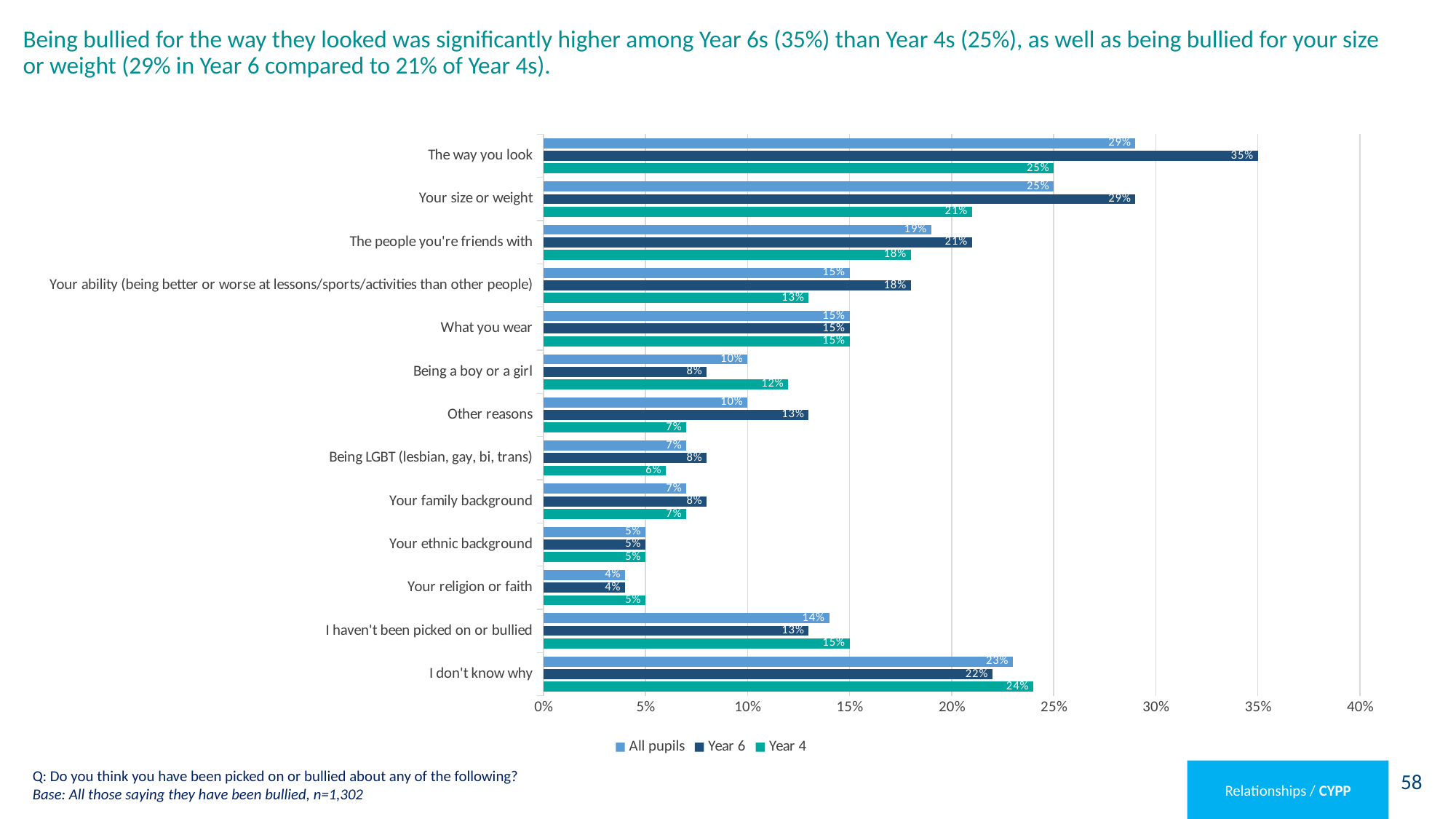
What is the Year 6 value for "Other reasons"? 13% What is the Year 4 value for "Your size or weight"? 21% Which series is shown in green in the legend? Year 4 What kind of chart is shown on the slide? Bar chart Which category has the highest Year 6 value? The way you look How many categories are shown on the chart? 13 Which is larger for "Being a boy or a girl": the Year 6 value or the Year 4 value? Year 4 What is the difference between the Year 6 and Year 4 values for "The way you look"? 10% Which category has the lowest All pupils value? Your religion or faith What is the Year 6 value for "The way you look"? 35% What is the All pupils value for "I don't know why"? 23% How many series does the legend list? 3